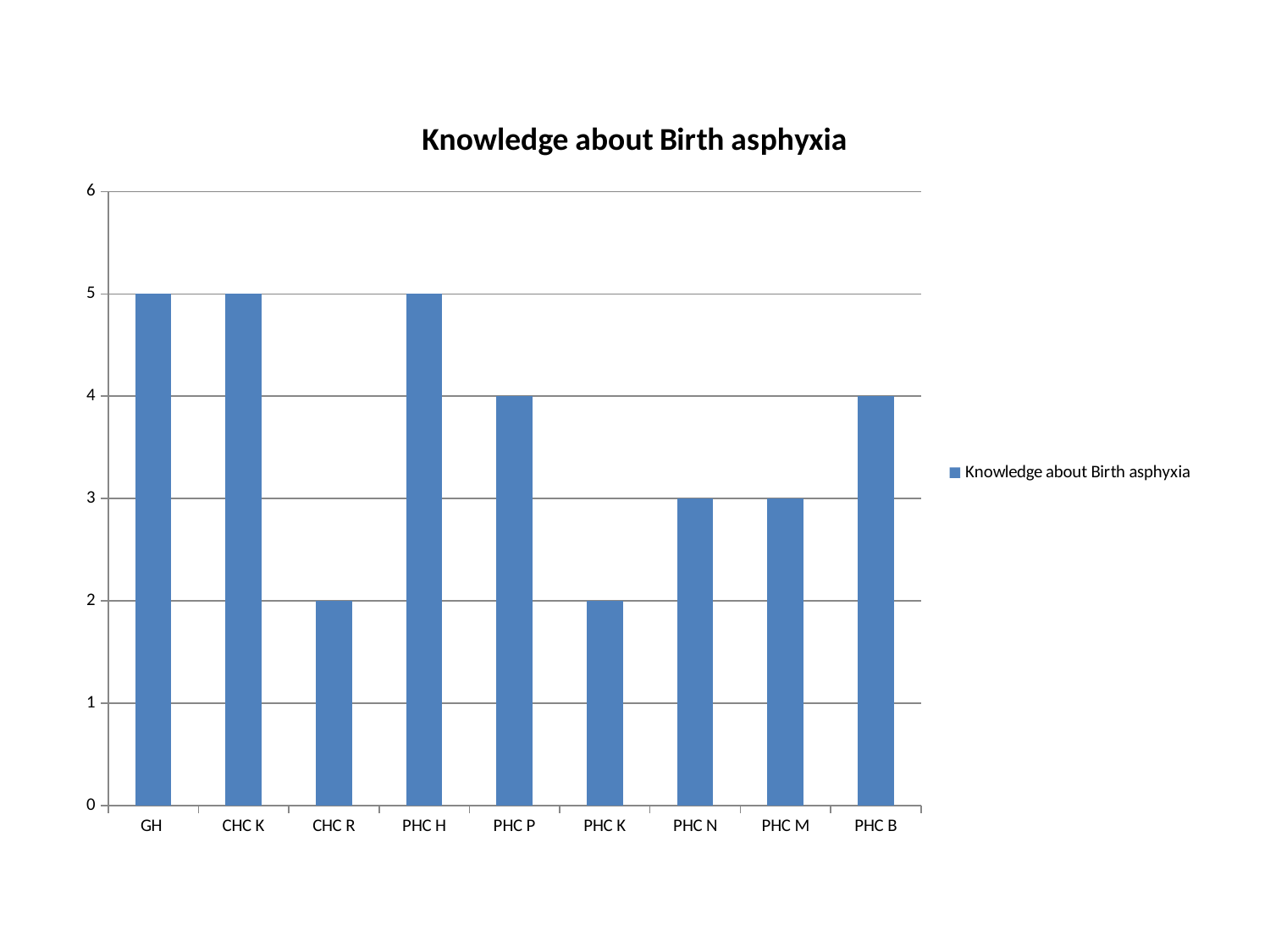
What is the title of the chart? Knowledge about Birth asphyxia What is the value for PHC N? 3 What is the difference between the values for PHC B and PHC M? 1 Is the value for PHC K greater or less than 3? less What kind of chart is this? bar chart What is the value for PHC P? 4 What is the value for CHC R? 2 What is the difference between the values for PHC H and PHC K? 3 What is the value for GH? 5 How many categories are shown on the x axis? 9 Which is larger, the value for PHC N or the value for PHC B? PHC B Which is larger, the value for CHC K or the value for CHC R? CHC K